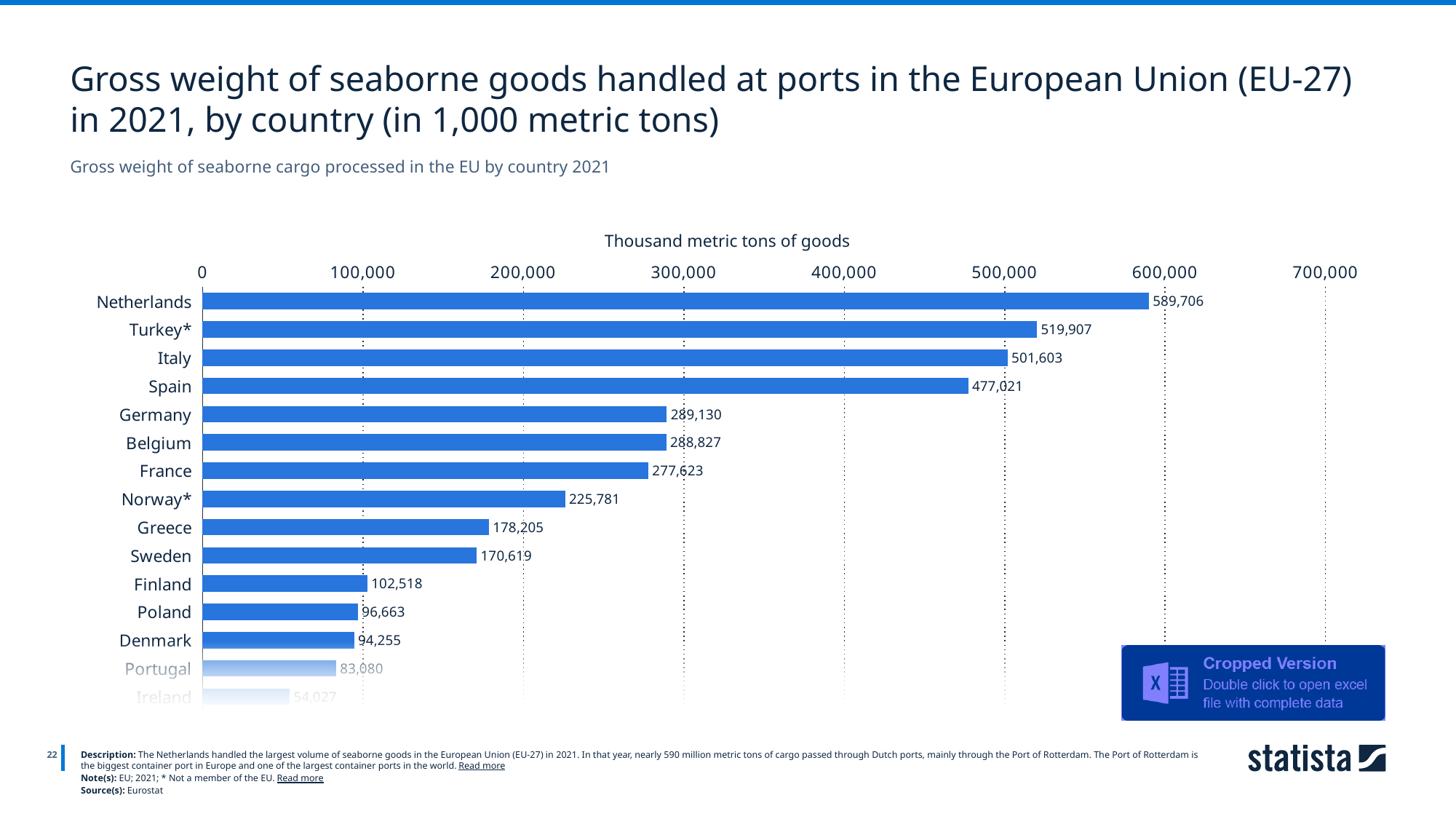
What value is shown for Germany? 289,130 Which country has the highest gross weight of seaborne goods handled? Netherlands Is the value for Norway* greater or less than 200,000? greater Which country has the lowest value among the clearly labelled bars, Denmark or Poland? Denmark Which has a larger value, Italy or Spain? Italy What is the difference between the values for the Netherlands and Turkey*? 69,799 What kind of chart is shown on the slide? Bar chart Is the value for France greater or less than 300,000? less What value is shown for Finland? 102,518 What is the gross weight of seaborne goods handled at ports in the Netherlands in 2021? 589,706 What is the label of the horizontal axis? Thousand metric tons of goods What is the difference between the values for Italy and Spain? 24,582